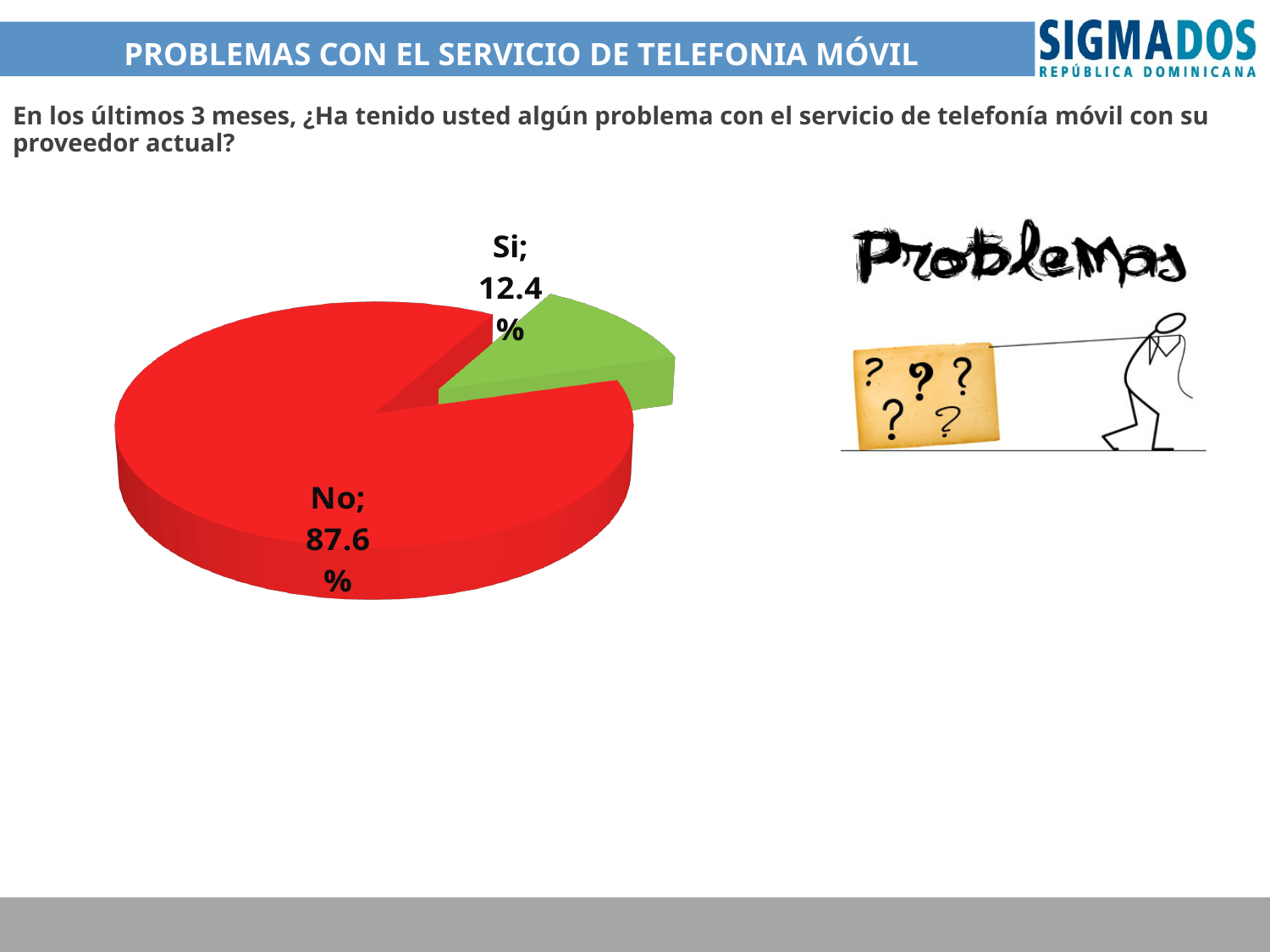
Which is larger, the share for "Si" or the share for "No"? No What percentage of respondents answered "Si"? 12.4% Which response has the smallest share of the pie? Si What kind of chart is shown on the slide? Pie chart What is the difference in percentage points between the "No" and "Si" responses? 75.2 What percentage of respondents answered "No"? 87.6% How many slices does the pie chart have? 2 Which response has the largest share of the pie? No What share of the pie does the "Si" slice represent? 12.4% What colour is the "Si" slice of the pie chart? Green What colour is the "No" slice of the pie chart? Red